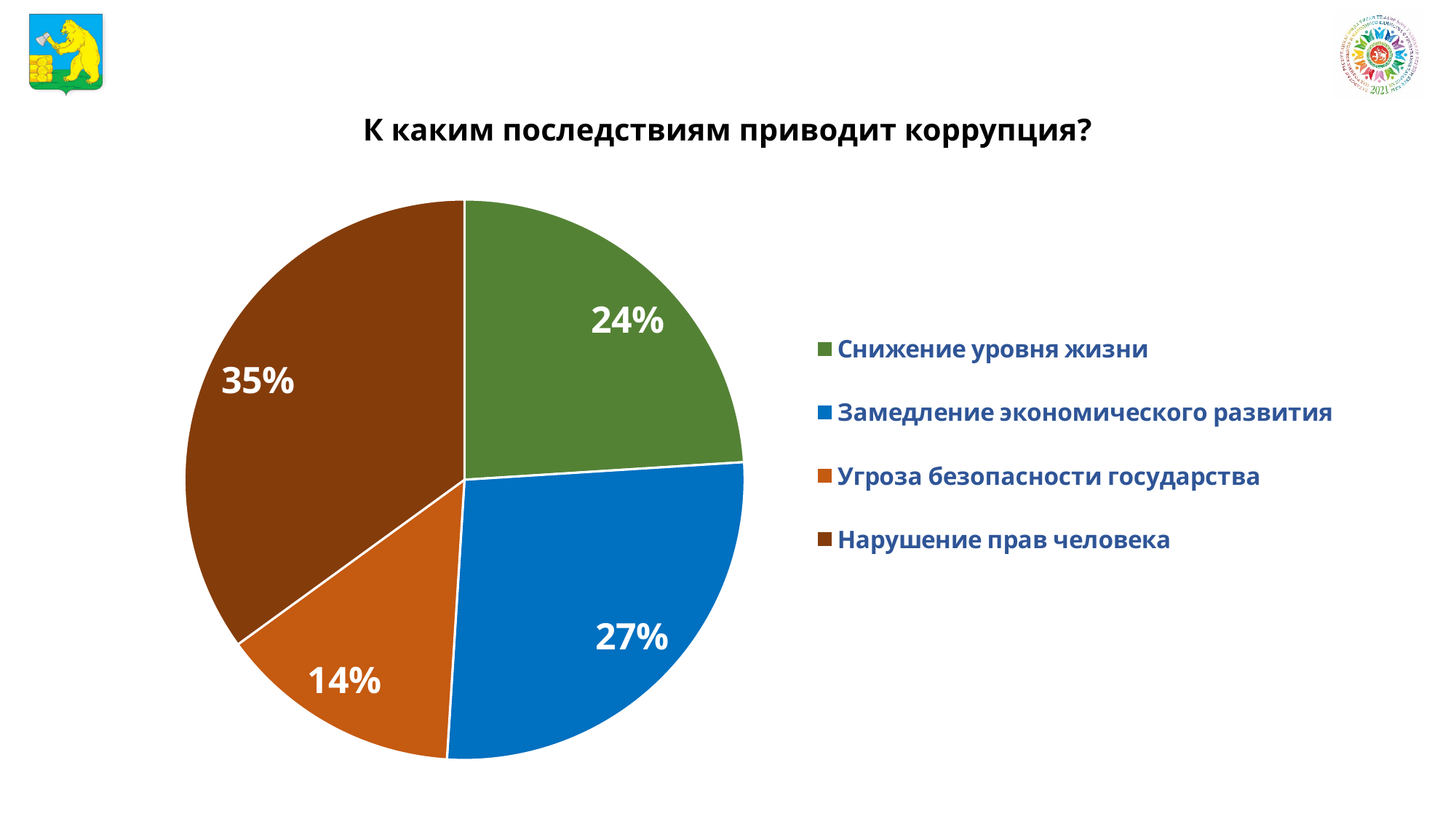
How many categories does the pie chart have? 4 Which category has the largest share of the pie? Нарушение прав человека Which category has the smallest share of the pie? Угроза безопасности государства What is the value for Замедление экономического развития? 27% Which is larger: Замедление экономического развития or Снижение уровня жизни? Замедление экономического развития What is the title of the chart? К каким последствиям приводит коррупция? What is the value for Снижение уровня жизни? 24% What is the value for Нарушение прав человека? 35% What kind of chart is shown on the slide? pie chart What colour is the slice for Замедление экономического развития? blue What is the difference between the values for Нарушение прав человека and Угроза безопасности государства? 21% What is the value for Угроза безопасности государства? 14%